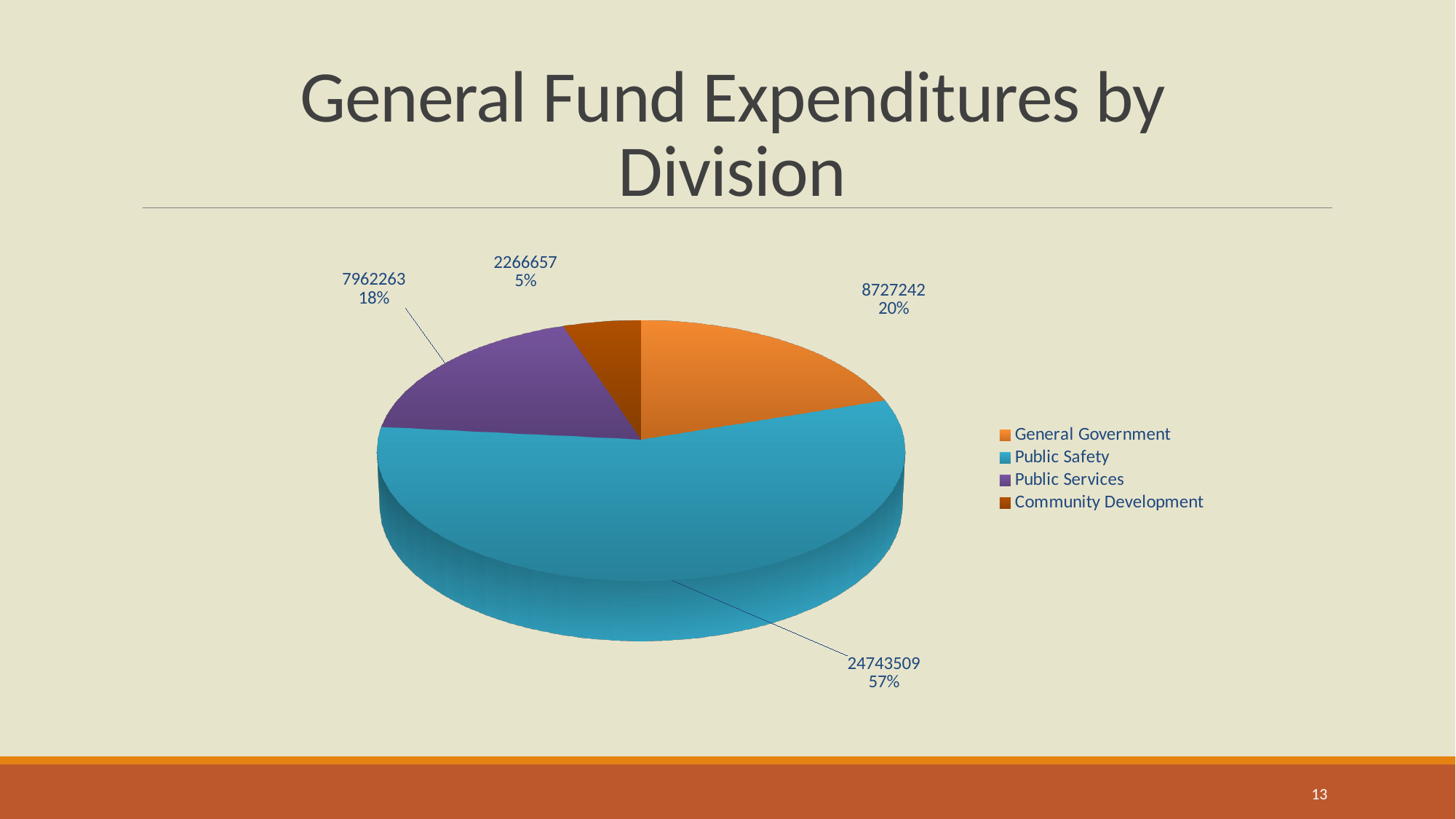
How many divisions are shown in the chart? 4 What kind of chart is shown on the slide? Pie chart What is the value for General Government? 8727242 What percentage share does Public Services have? 18% What is the value for Public Safety? 24743509 What is the value for Public Services? 7962263 What is the difference between the General Government and Public Services values? 764979 Which division has the largest share of expenditures? Public Safety Which division has the smallest share of expenditures? Community Development Which is larger, General Government or Community Development? General Government What percentage share does Public Safety have? 57% What is the value for Community Development? 2266657